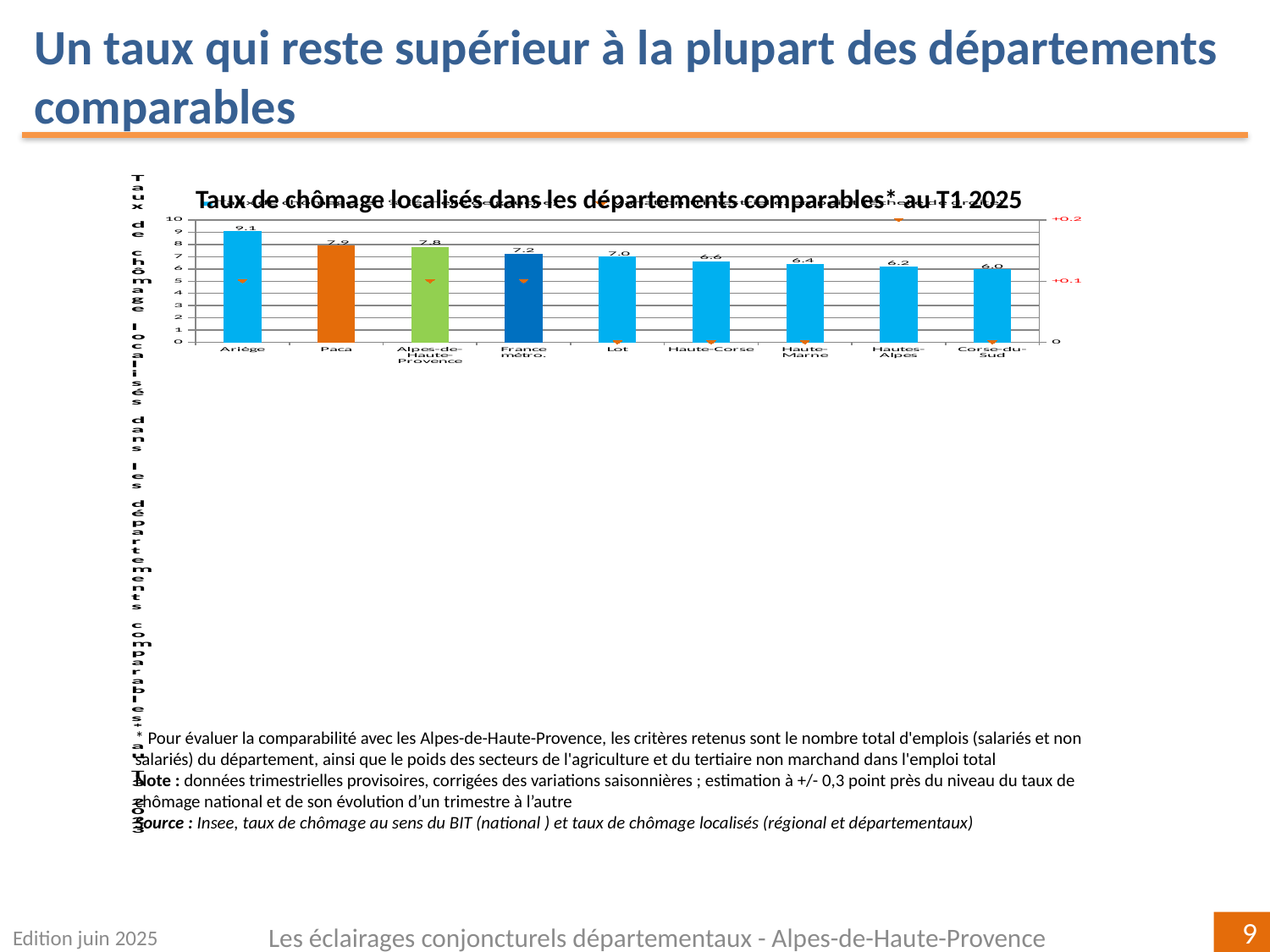
What is the value shown for Alpes-de-Haute-Provence? 7.8 Do the bar values rise or fall from left to right along the x axis? Fall Which category has the highest bar? Ariège What is the unemployment rate shown for Ariège? 9.1 What is the difference between the values for Alpes-de-Haute-Provence and Hautes-Alpes? 1.6 What is the difference between the values for Ariège and Paca? 1.2 What is the value shown for Corse-du-Sud? 6.0 Which is larger, the value for Lot or the value for Haute-Corse? Lot How many categories are shown on the x axis? 9 What is the value shown for France métro.? 7.2 What kind of chart is this? Bar chart Which category has the lowest bar? Corse-du-Sud